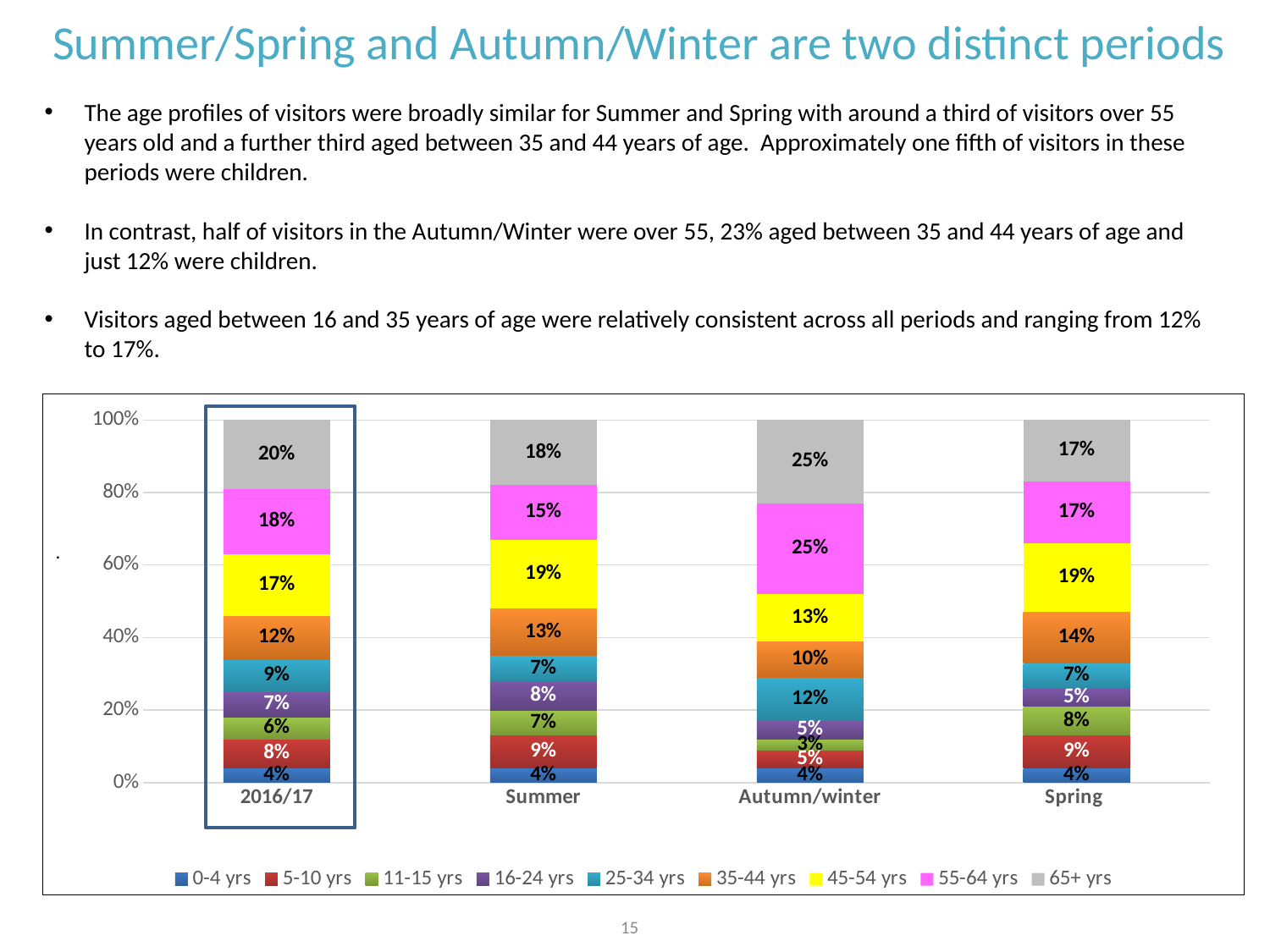
Which category has the lowest value for 11-15 yrs? Autumn/winter What is the value for 25-34 yrs in the 2016/17 bar? 9% Which is larger, the 35-44 yrs value for Summer or for Autumn/winter? Summer What is the difference between the 65+ yrs values for Autumn/winter and Spring? 8% What is the value for 35-44 yrs in the Spring bar? 14% What kind of chart is shown on the slide? Stacked bar chart What is the value for 45-54 yrs in the Summer bar? 19% What is the value for 65+ yrs in the Autumn/winter bar? 25% Which category on the x axis is outlined with a box? 2016/17 How many series does the legend list? 9 How many categories are shown on the x axis? 4 Which category has the highest value for 55-64 yrs? Autumn/winter